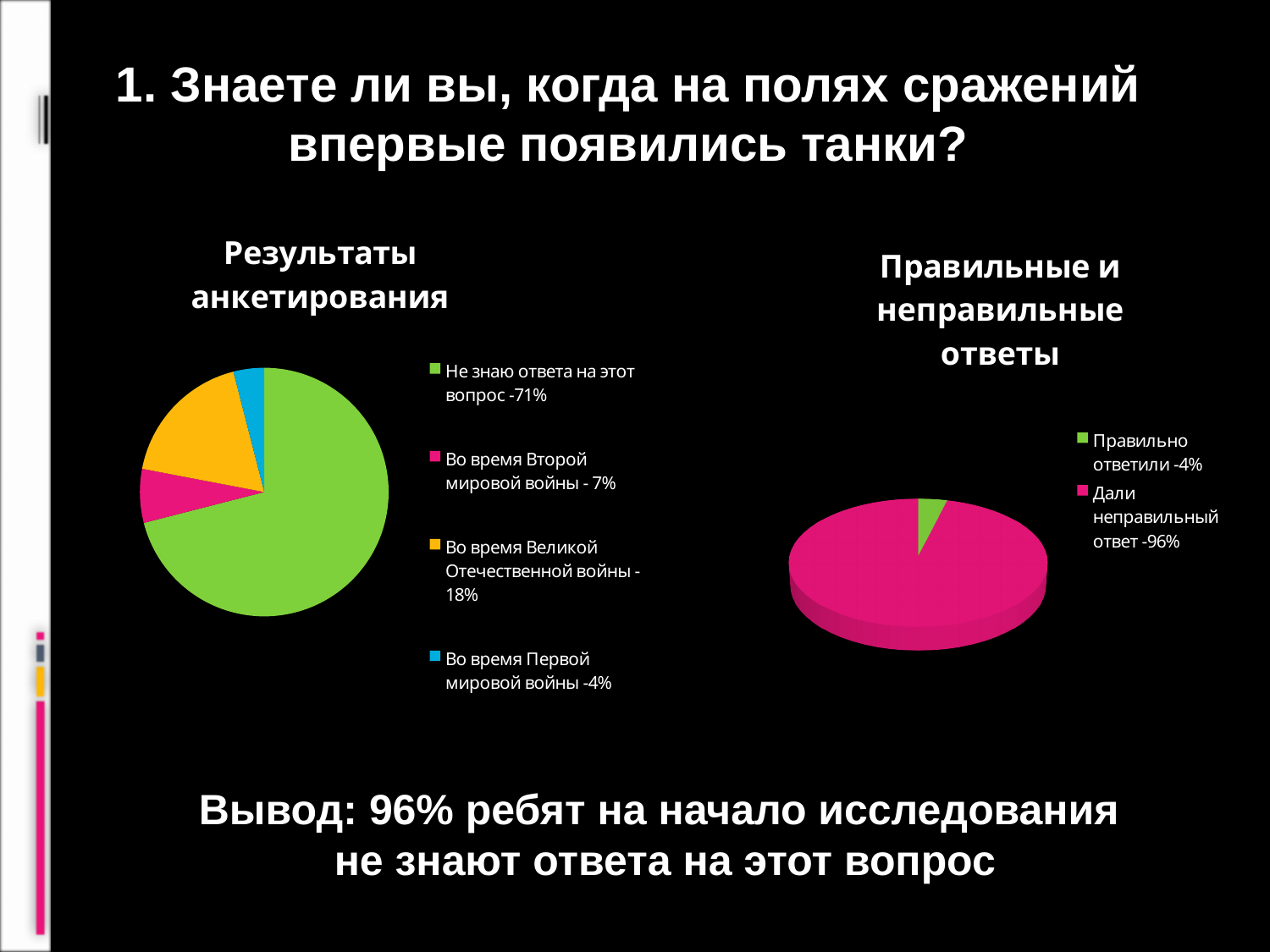
In the right chart "Правильные и неправильные ответы", what share of respondents gave an incorrect answer ("Дали неправильный ответ")? 96% In the left chart "Результаты анкетирования", what is the difference between the share for "Во время Великой Отечественной войны" and the share for "Во время Второй мировой войны"? 11% In the left chart "Результаты анкетирования", which is larger: the share for "Во время Второй мировой войны" or the share for "Во время Великой Отечественной войны"? Во время Великой Отечественной войны In the right chart "Правильные и неправильные ответы", what share of respondents answered correctly ("Правильно ответили")? 4% In the left chart "Результаты анкетирования", what share of respondents answered "Не знаю ответа на этот вопрос"? 71% In the right chart "Правильные и неправильные ответы", how many entries does the legend list? 2 What kind of chart is the left chart titled "Результаты анкетирования"? pie chart In the left chart "Результаты анкетирования", what share of respondents answered "Во время Первой мировой войны"? 4% In the left chart "Результаты анкетирования", which answer has the largest share? Не знаю ответа на этот вопрос In the left chart "Результаты анкетирования", how many slices does the pie have? 4 In the left chart "Результаты анкетирования", which answer has the smallest share? Во время Первой мировой войны In the left chart "Результаты анкетирования", what share of respondents answered "Во время Великой Отечественной войны"? 18%